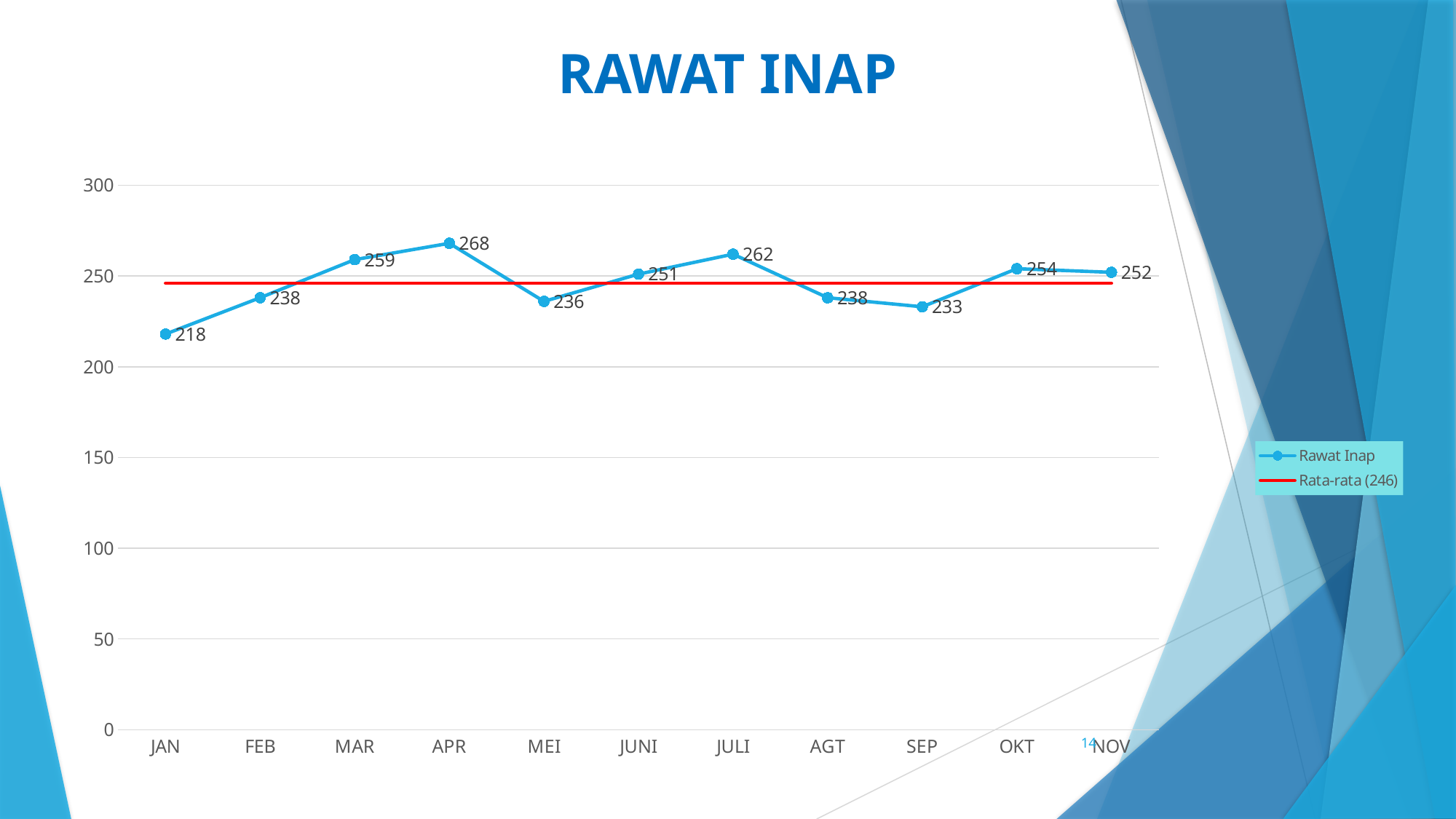
What is the Rawat Inap value for JAN? 218 What is the Rawat Inap value for SEP? 233 What is the Rawat Inap value for APR? 268 Which month has the lowest Rawat Inap value? JAN What kind of chart is shown on the slide? line chart Is the Rawat Inap value for OKT greater or less than 200? greater How many months are shown on the x axis? 11 What is the title of the chart? RAWAT INAP Which month has the highest Rawat Inap value? APR How many series does the legend list? 2 What is the difference between the Rawat Inap values for APR and JAN? 50 Which is larger, the Rawat Inap value for JULI or for MEI? JULI